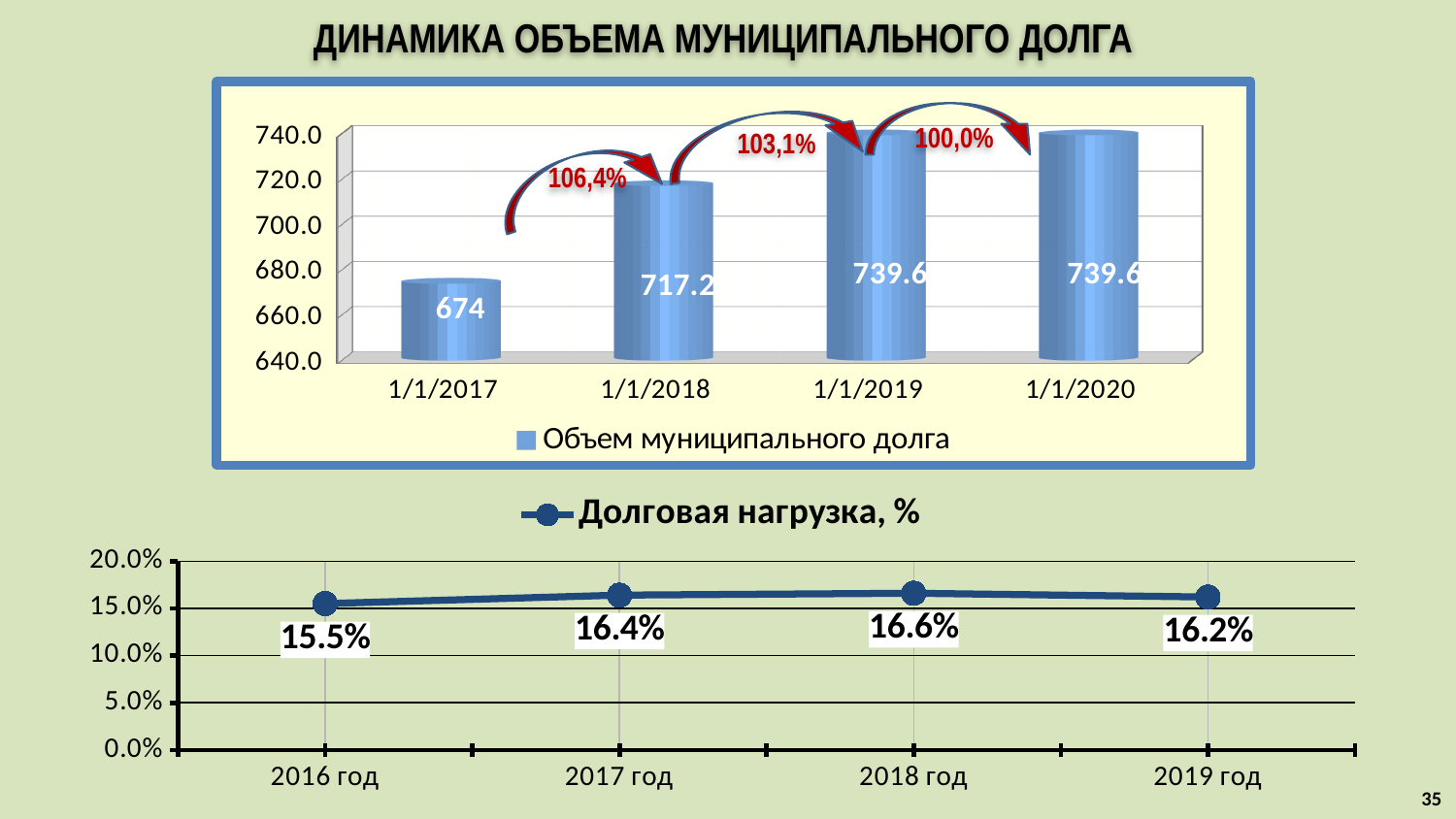
What kind of chart is the top chart showing Объем муниципального долга? bar chart In the bottom line chart Долговая нагрузка, %, which year has the lowest value? 2016 год In the top bar chart, what is the value of Объем муниципального долга for 1/1/2017? 674 In the bottom line chart Долговая нагрузка, %, is the value for 2017 год larger or smaller than the value for 2019 год? larger In the top bar chart, what percentage is shown on the arrow between 1/1/2017 and 1/1/2018? 106,4% In the top bar chart, how many dates are shown on the x axis? 4 In the bottom line chart Долговая нагрузка, %, what is the difference between the values for 2018 год and 2016 год? 1.1% In the top bar chart, which date has the lowest value of Объем муниципального долга? 1/1/2017 In the top bar chart, what is the value of Объем муниципального долга for 1/1/2019? 739.6 In the top bar chart, what is the value of Объем муниципального долга for 1/1/2018? 717.2 In the bottom line chart Долговая нагрузка, %, what is the value for 2018 год? 16.6% In the top bar chart, what is the difference between the values for 1/1/2018 and 1/1/2017? 43.2